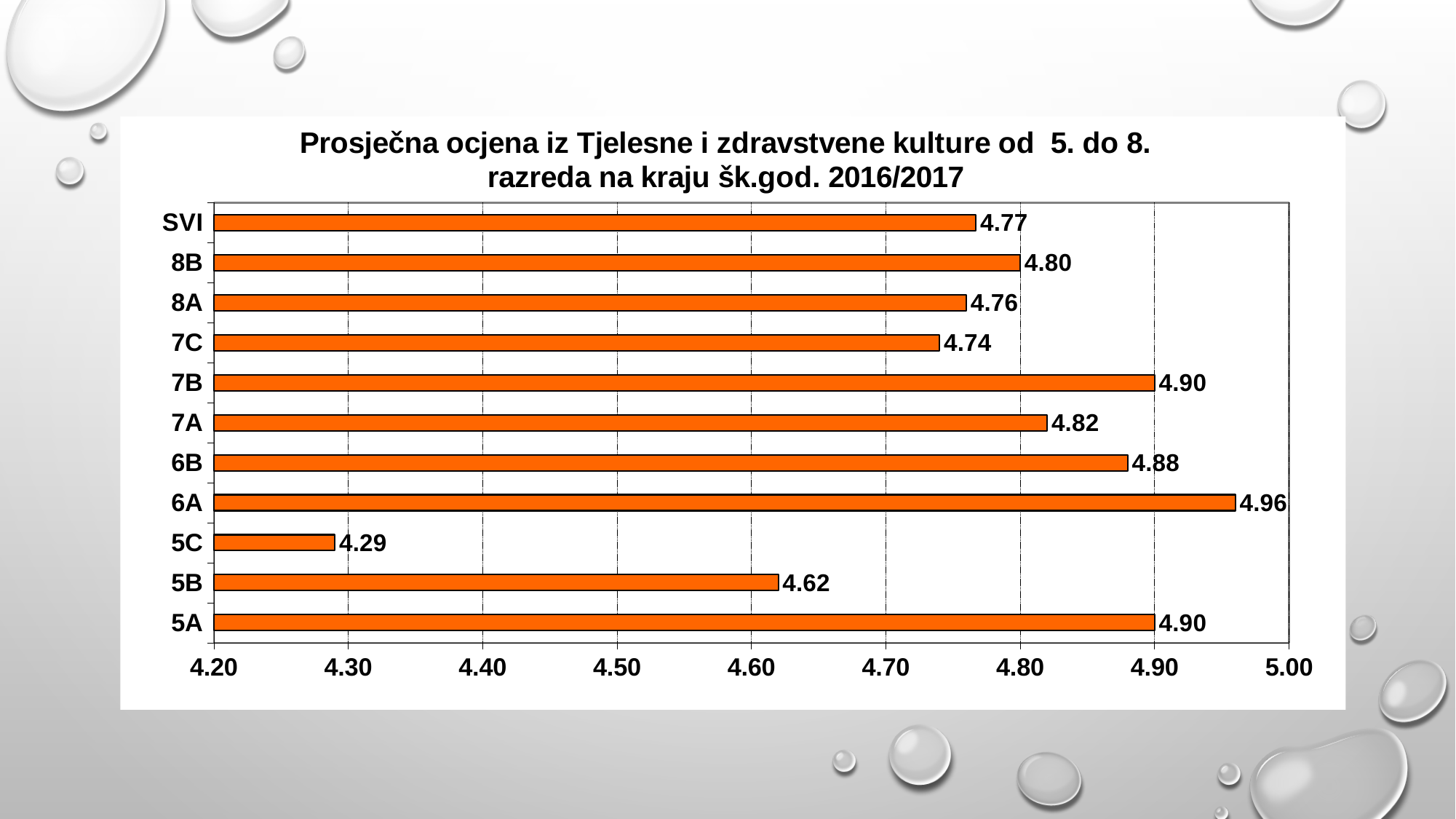
What is the average grade for class 6A? 4.96 Which class has the highest average grade? 6A What is the value shown for 5C? 4.29 How many categories are shown on the chart? 11 Which has a higher value, 7B or 7C? 7B What is the value shown for SVI? 4.77 What is the difference between the values for 6A and 5C? 0.67 Which class has the lowest average grade? 5C Is the value for 5B greater or less than 4.70? less What colour are the bars in the chart? orange What kind of chart is this? bar chart What is the difference between the values for 8B and 8A? 0.04